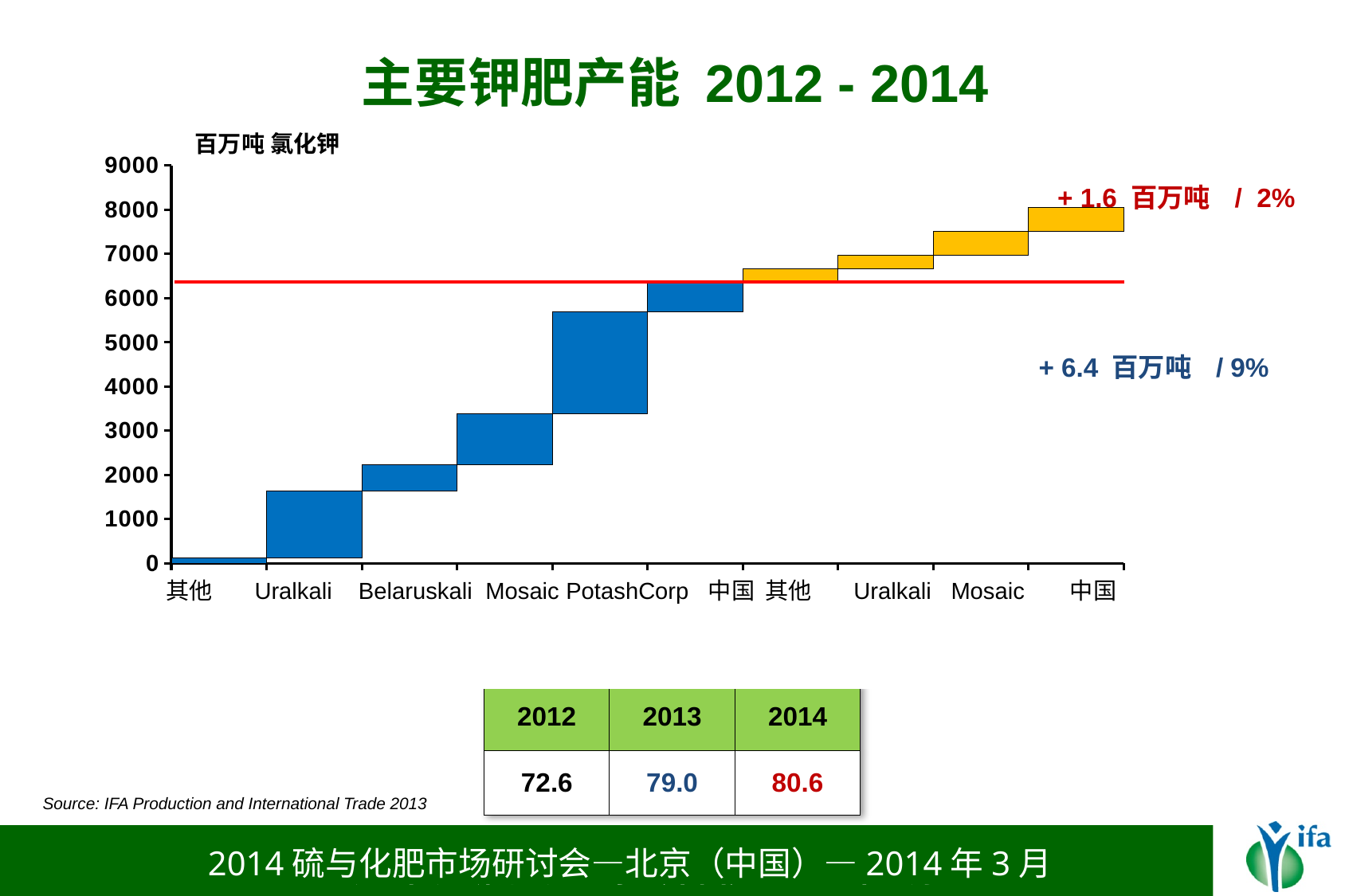
Do the cumulative values rise or fall from left to right along the x axis? rise What is the total capacity value shown in the table for 2014? 80.6 What is the difference between the 2014 and 2012 values in the table? 8.0 What kind of chart is shown on the slide? bar chart (waterfall) What is the title of the chart on the slide? 主要钾肥产能 2012 - 2014 Which category has the largest single bar segment in the chart? PotashCorp According to the annotation, by how much did the yellow segments (2013 to 2014) increase capacity? + 1.6 百万吨 / 2% Is the top of the PotashCorp bar greater or less than 5000? greater According to the annotation, by how much did the blue segments (2012 to 2013) increase capacity? + 6.4 百万吨 / 9% How many categories are shown along the x axis of the chart? 10 What unit is shown for the y axis of the chart? 百万吨 氯化钾 Is the top of the first Mosaic bar greater or less than 4000? less